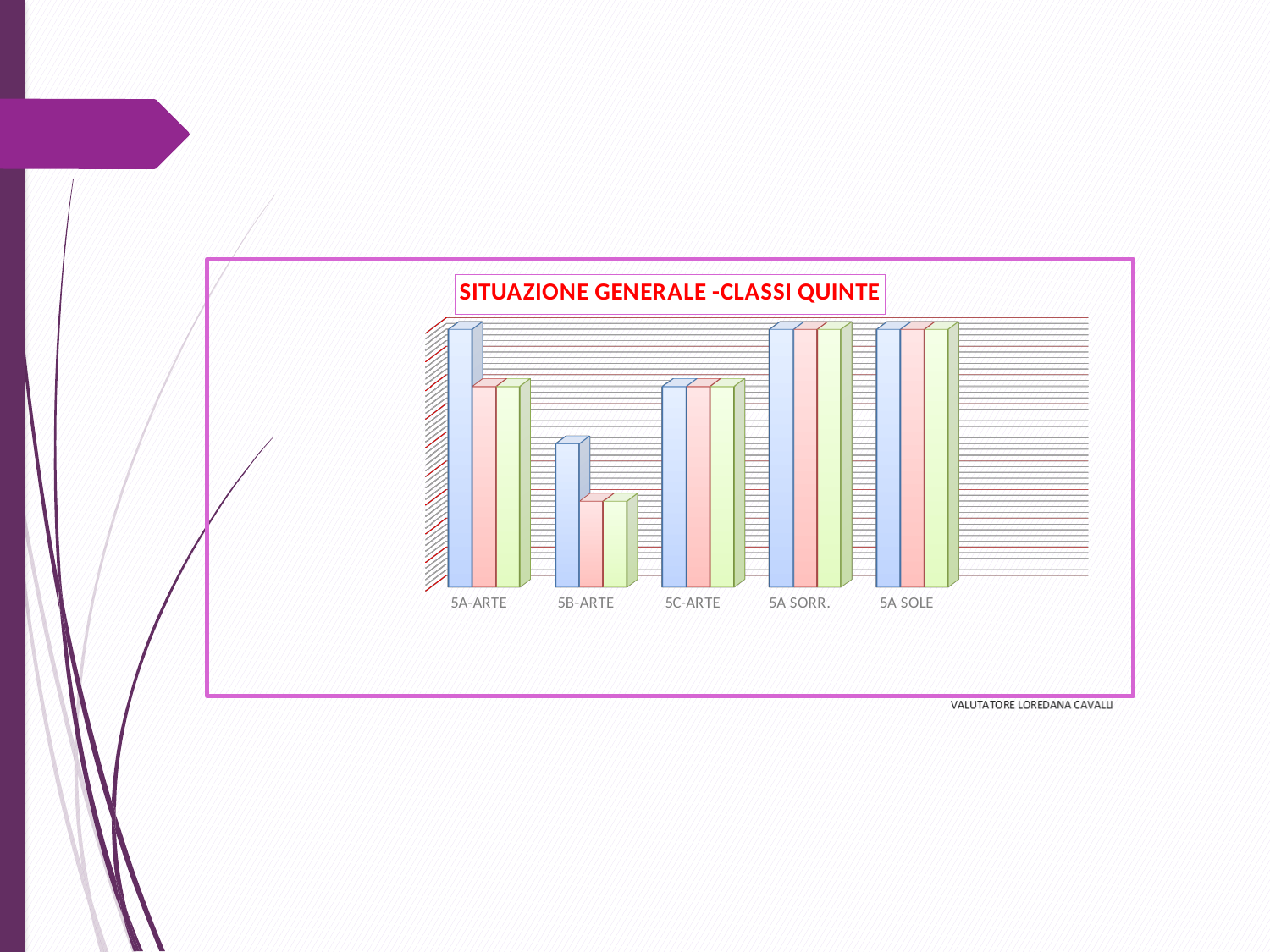
Which is larger, the pink bar for 5B-ARTE or the pink bar for 5C-ARTE? 5C-ARTE Within the 5A-ARTE category, which is larger, the blue bar or the pink bar? the blue bar Which is larger, the blue bar for 5A-ARTE or the blue bar for 5B-ARTE? 5A-ARTE Which category has the lowest bars in the chart? 5B-ARTE How many categories are shown on the x axis of the chart? 5 What is the label of the first category on the x axis of the chart? 5A-ARTE What is the title of the chart? SITUAZIONE GENERALE -CLASSI QUINTE What kind of chart is shown on the slide? bar chart How many bars are plotted for each category in the chart? 3